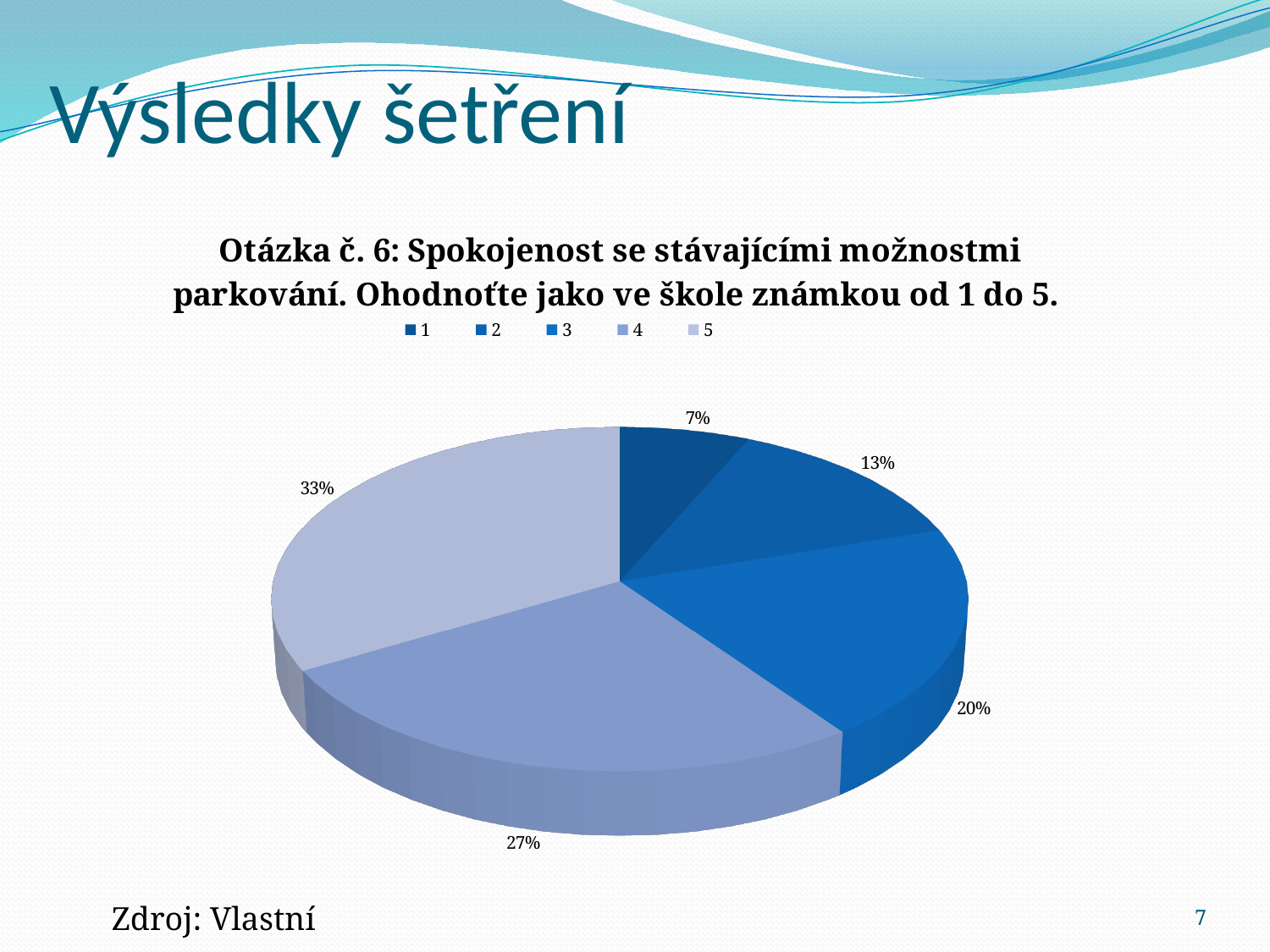
What percentage of respondents gave a rating of 2? 13% How many categories does the legend list? 5 What percentage of respondents gave a rating of 3? 20% Which has a larger share, rating 3 or rating 4? 4 What percentage of respondents gave a rating of 1? 7% Which rating has the smallest share of the pie? 1 What is the title of the chart? Otázka č. 6: Spokojenost se stávajícími možnostmi parkování. Ohodnoťte jako ve škole známkou od 1 do 5. What type of chart is shown on the slide? Pie chart What percentage of respondents gave a rating of 4? 27% What is the difference in percentage points between the share for rating 5 and the share for rating 1? 26 Which rating has the largest share of the pie? 5 What percentage of respondents gave a rating of 5? 33%